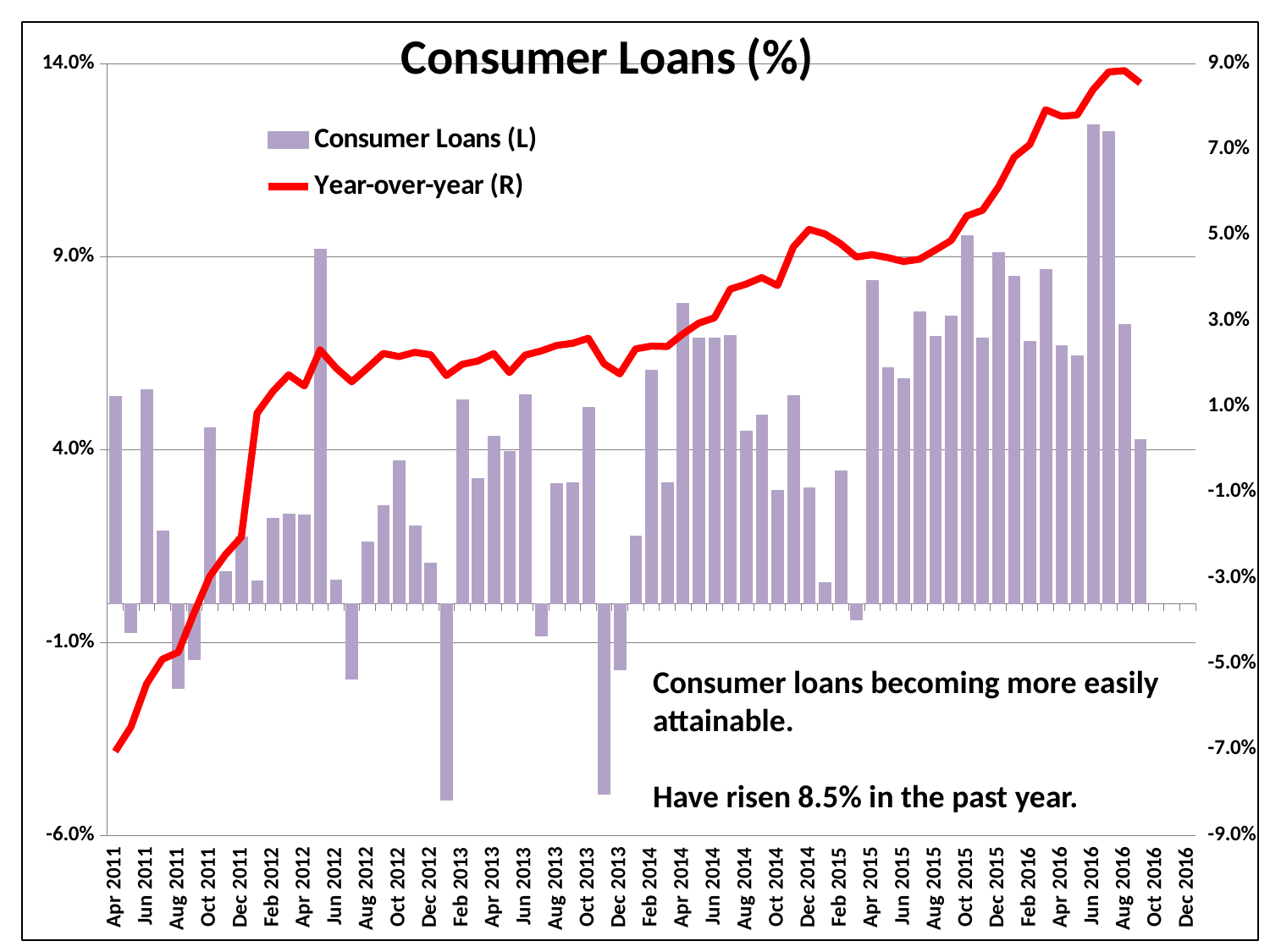
Which is larger, the Consumer Loans (L) bar for Apr 2011 or for Aug 2011? Apr 2011 Is the Year-over-year (R) value for Aug 2016 greater or less than 7.0%? greater At which month is the Year-over-year (R) line at its lowest? Apr 2011 How many series does the legend list? 2 Is the Consumer Loans (L) bar for Jun 2016 greater or less than 9.0%? greater What kind of chart is this? Combined bar and line chart Is the Year-over-year (R) value for Apr 2011 greater or less than -5.0%? less Which is larger, the Consumer Loans (L) bar for Jun 2016 or for Apr 2012? Jun 2016 Which series is plotted as a red line? Year-over-year (R) Does the Year-over-year (R) line generally rise or fall from Apr 2011 to Aug 2016? Rise What is the title of the chart? Consumer Loans (%)